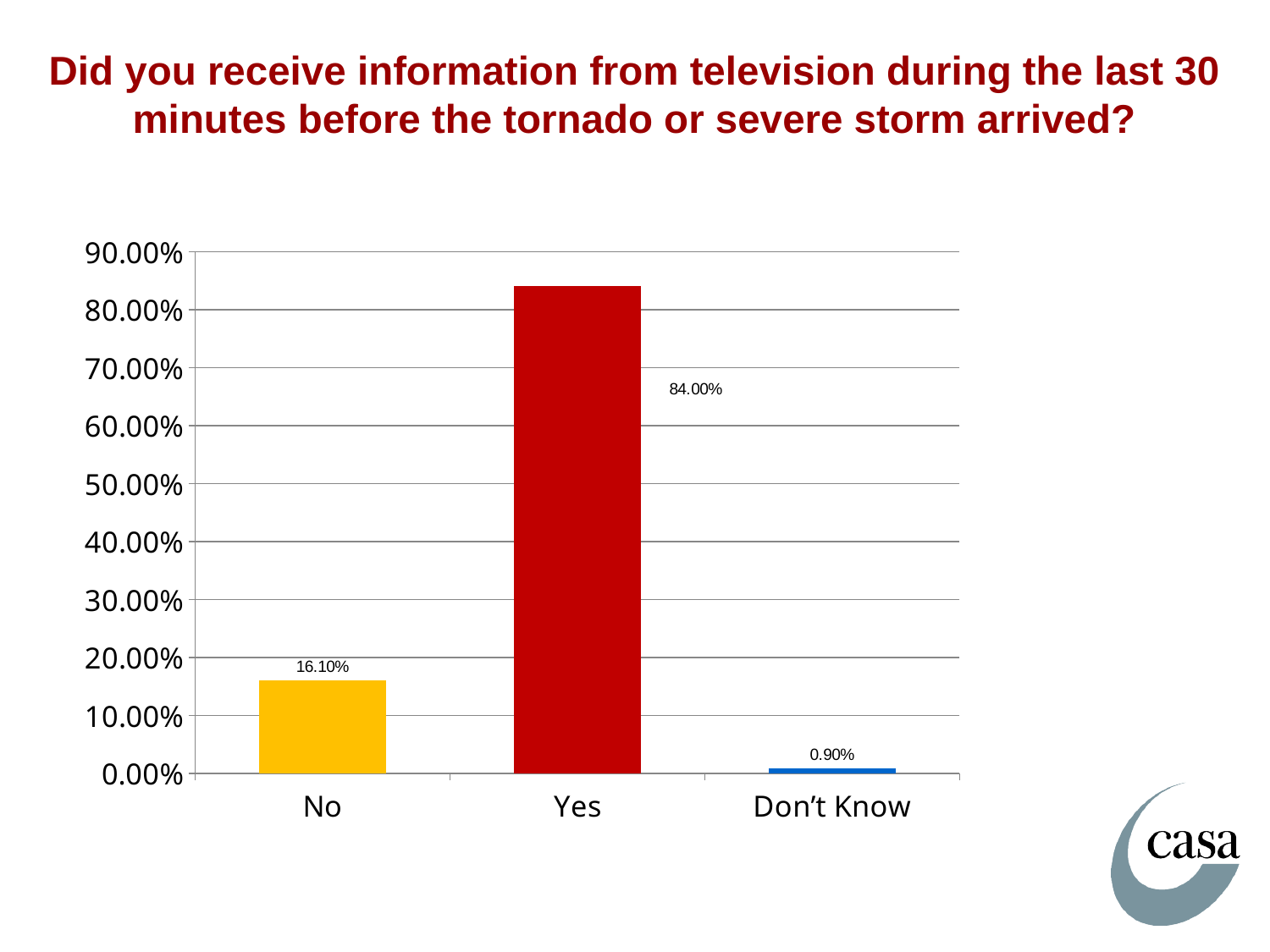
Which category has the highest value? Yes What kind of chart is shown on the slide? bar chart What is the difference between the values for "Yes" and "No"? 67.90% What is the difference between the values for "No" and "Don't Know"? 15.20% What is the value for the "Don't Know" category? 0.90% Which is larger, the value for "No" or the value for "Don't Know"? No What is the value for the "Yes" category? 84.00% Is the value for "Yes" greater or less than 80.00%? greater What is the value for the "No" category? 16.10% What colour is the bar for the "Yes" category? red How many categories are shown on the x axis? 3 Which category has the lowest value? Don't Know